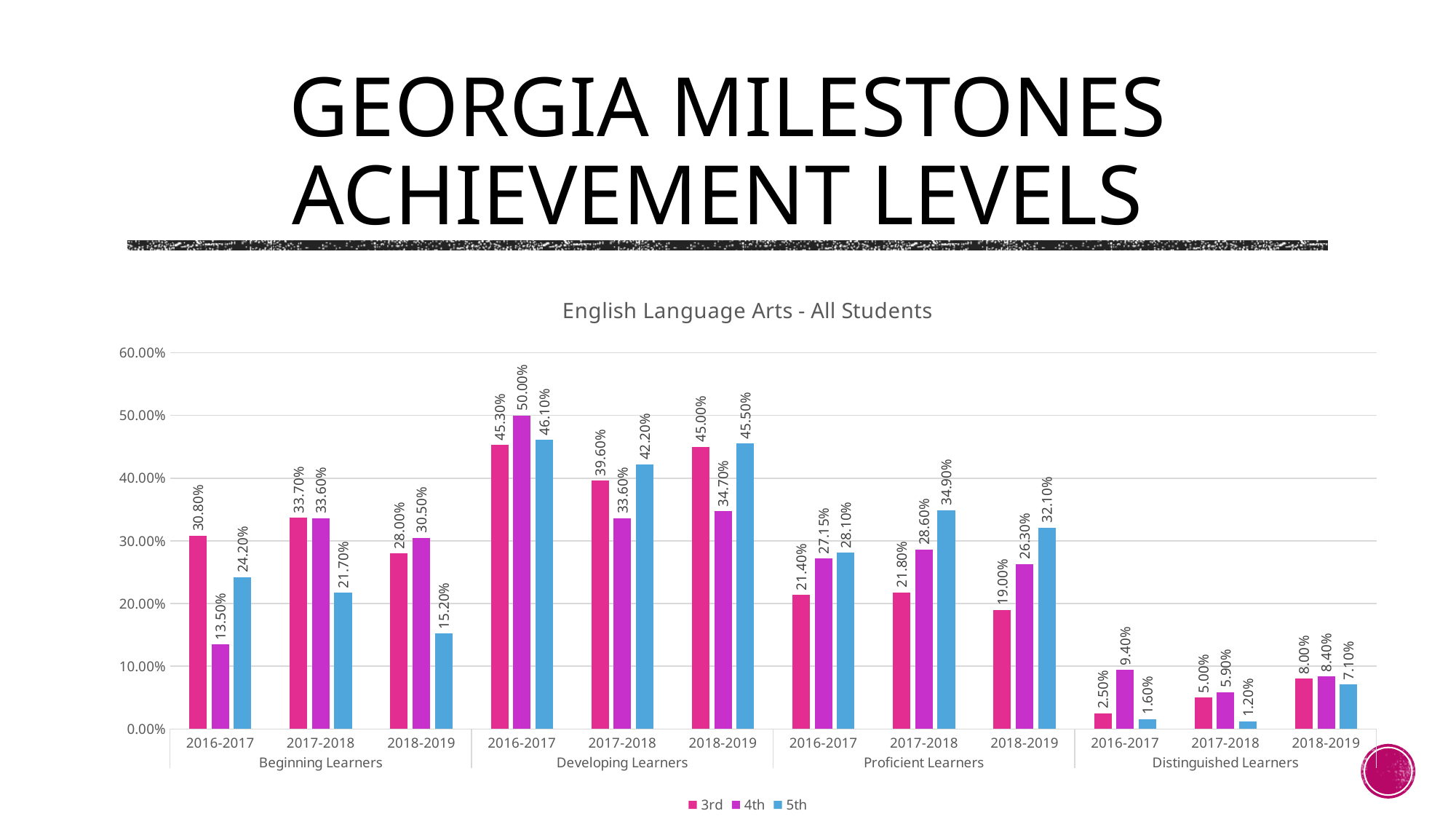
Which is larger under Developing Learners in 2017-2018: the 3rd grade value or the 4th grade value? 3rd Which series has the lowest value in 2017-2018 under Distinguished Learners? 5th What is the difference between the 5th grade and 3rd grade values in 2018-2019 under Proficient Learners? 13.10% How does the 3rd grade value change across the three years under Proficient Learners, from 2017-2018 to 2018-2019? falls Is the 5th grade value for 2018-2019 under Beginning Learners greater or less than 20.00%? less What is the value for 4th grade in 2016-2017 under Developing Learners? 50.00% How many series does the legend list? 3 What type of chart is shown on the slide? bar chart Which series has the highest value in 2016-2017 under Beginning Learners? 3rd What is the value for 3rd grade in 2016-2017 under Distinguished Learners? 2.50% What is the title of the chart? English Language Arts - All Students What is the value for 5th grade in 2017-2018 under Proficient Learners? 34.90%